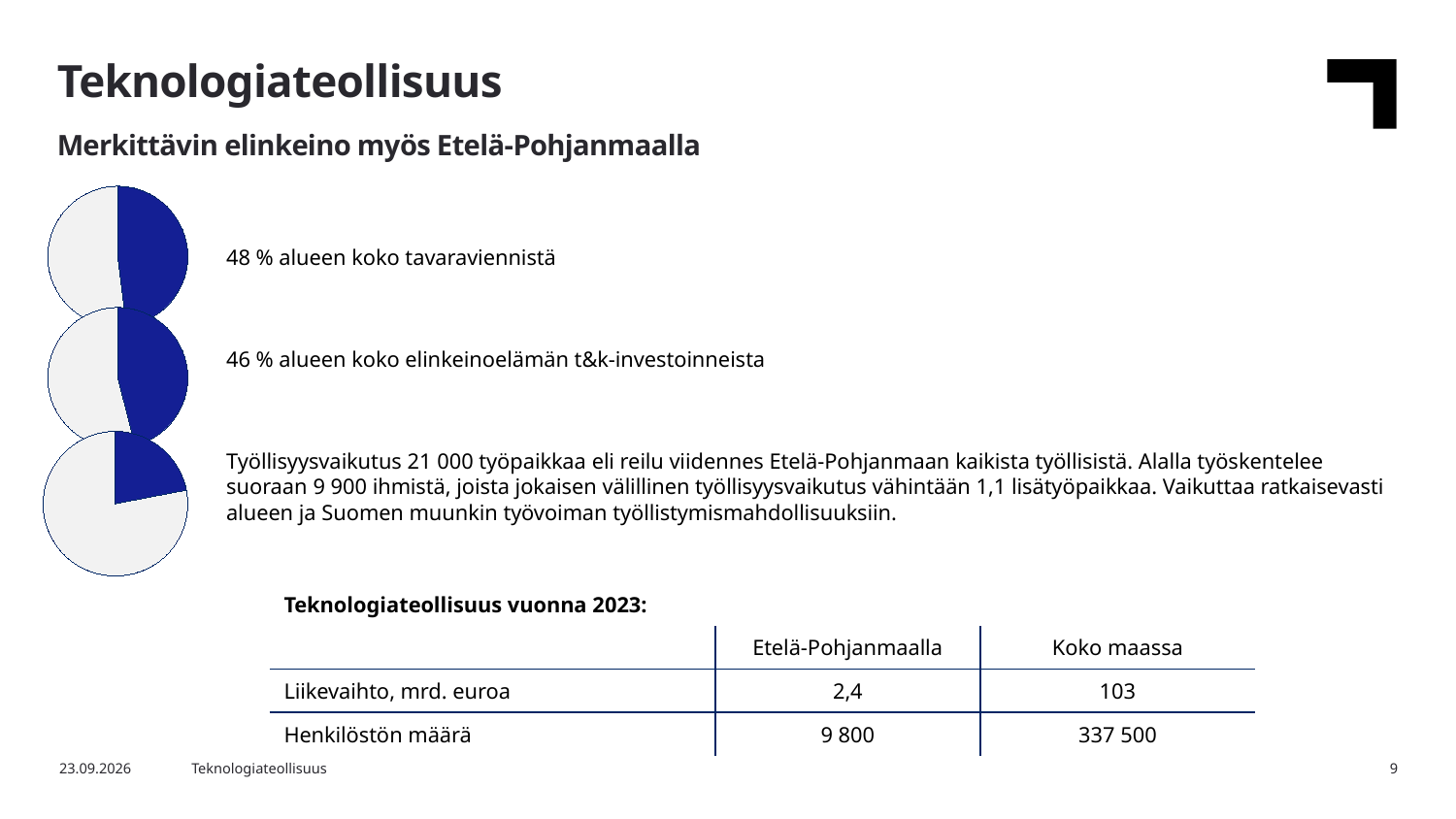
Which pie chart has the larger blue share, the top one (tavaravienti) or the middle one (t&k-investoinnit)? The top one (48 %) Which of the three pie charts has the largest blue share? The top one (tavaravienti, 48 %) Which of the three pie charts has the smallest blue share? The bottom one (työllisyysvaikutus) In the middle pie chart (t&k-investoinnit), what share does the blue slice represent? 46 % How many pie charts are shown on the slide? 3 What kind of chart is the top chart on the left of the slide? Pie chart What colour is the highlighted slice in each pie chart? Blue What does the top pie chart's blue slice represent according to the text next to it? 48 % alueen koko tavaraviennistä In the top pie chart (tavaravienti), what share does the blue slice represent? 48 % What is the difference in percentage points between the blue share of the top pie chart (48 %) and the middle pie chart (46 %)? 2 percentage points In the bottom pie chart (työllisyysvaikutus), is the blue slice greater or less than 50%? less